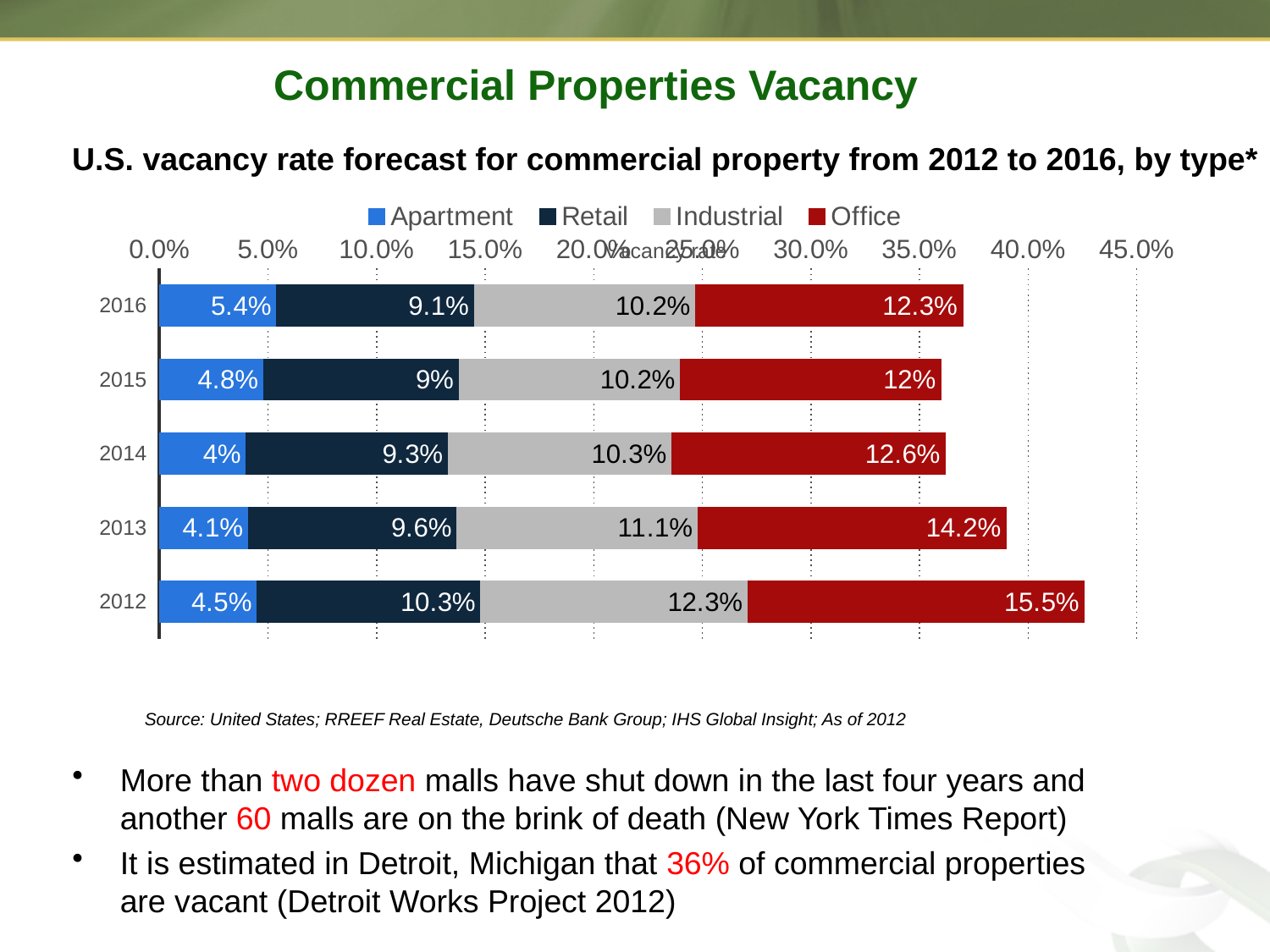
Which year has the highest Office vacancy rate? 2012 How many years are shown on the chart? 5 Which year has the lowest Apartment vacancy rate? 2014 What is the Office vacancy rate for 2012? 15.5% What is the Retail vacancy rate for 2014? 9.3% What is the difference between the Office vacancy rate in 2012 and in 2016? 3.2% Which is larger, the Retail vacancy rate in 2012 or in 2015? 2012 What is the Apartment vacancy rate for 2016? 5.4% What is the total of the stacked bar for 2012? 42.6% What kind of chart is shown on the slide? Stacked bar chart How many series does the legend list? 4 What is the Industrial vacancy rate for 2013? 11.1%